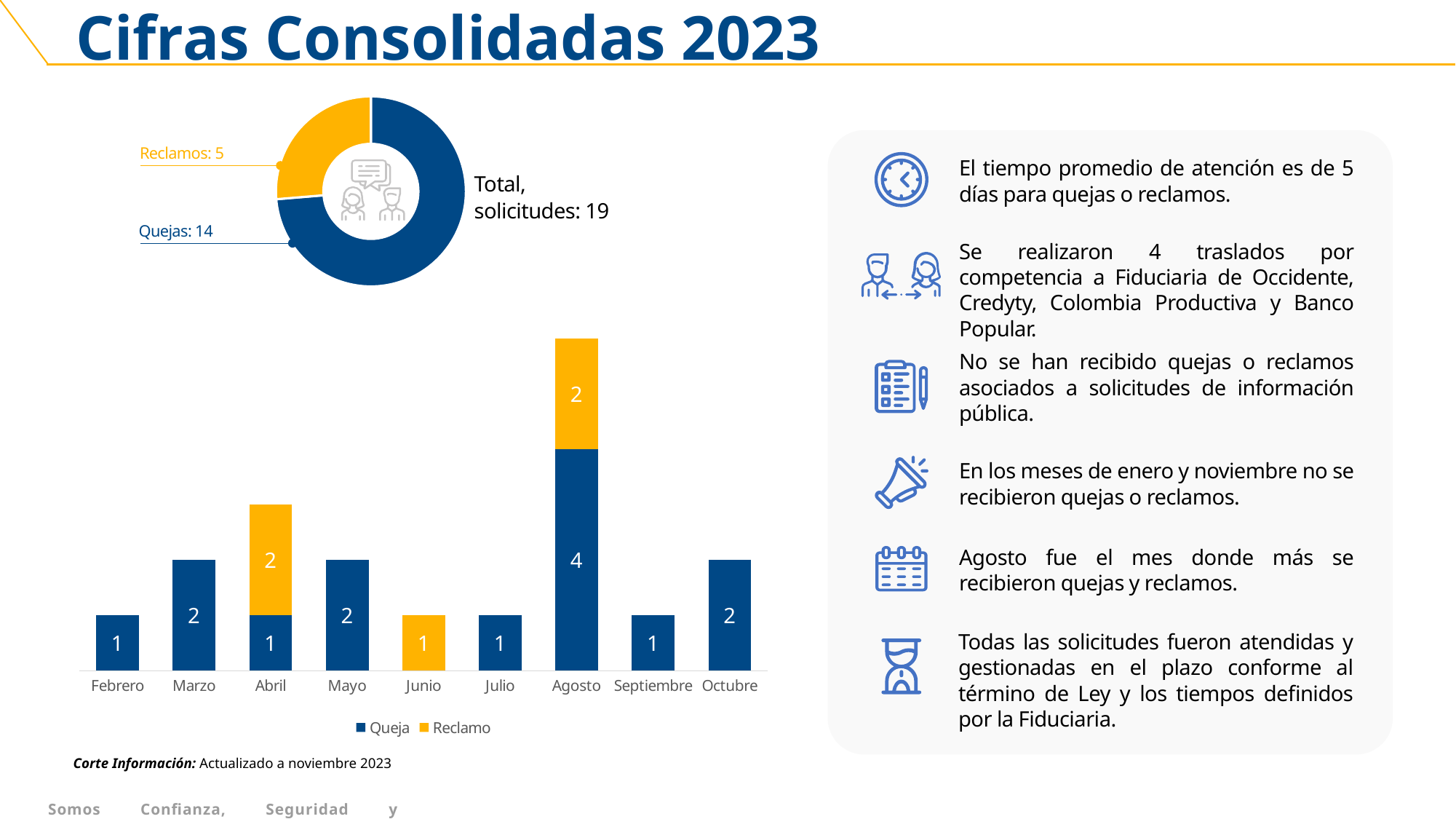
In the donut chart, what is the value for Reclamos? 5 In the bar chart, how many months are shown on the x axis? 9 In the bar chart, how many series does the legend list? 2 In the bar chart, what is the Queja value for Agosto? 4 In the bar chart, what is the difference between the Queja value for Agosto and the Queja value for Marzo? 2 In the donut chart, what is the value for Quejas? 14 In the bar chart, what is the Reclamo value for Abril? 2 In the donut chart, which category is larger, Quejas or Reclamos? Quejas In the bar chart, what is the total of the stacked bar for Agosto? 6 In the bar chart, what is the total of the stacked bar for Abril? 3 In the bar chart, which month has the highest stacked total? Agosto In the donut chart, what is the total number of solicitudes shown? 19